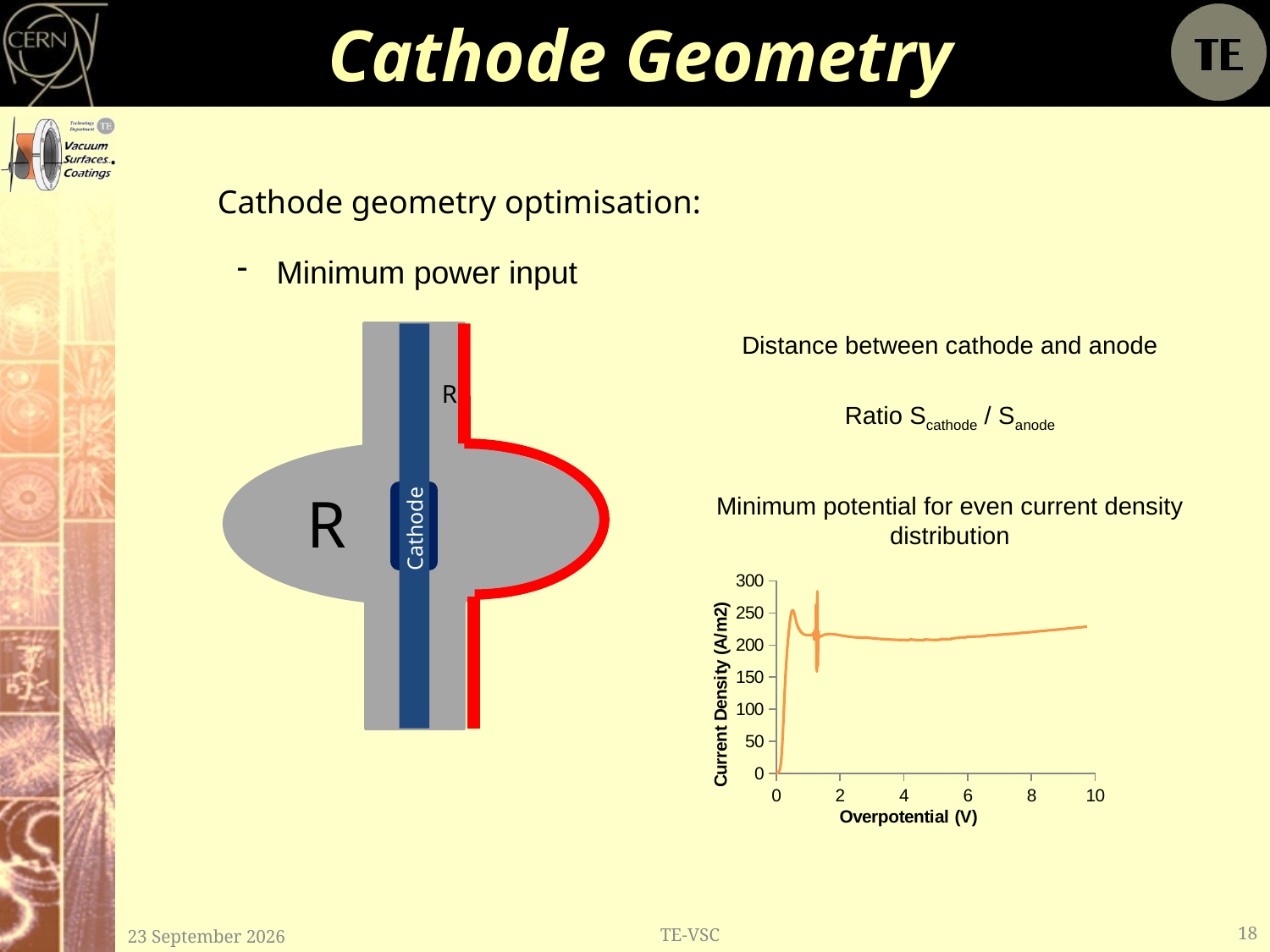
How many data series are plotted in the chart? 1 What is the label of the horizontal axis of the chart? Overpotential (V) Is the highest current density reached by the curve greater or less than 250? greater Between an overpotential of 0 V and 0.5 V, does the current density rise or fall? rise Between an overpotential of 4 V and 10 V, does the current density rise or fall? rise Is the current density at an overpotential of 4 V greater or less than 250? less What is the label of the vertical axis of the chart? Current Density (A/m2) What kind of chart is shown on the slide? line chart Is the current density at an overpotential of 8 V greater or less than 250? less What is the highest value shown on the vertical axis of the chart? 300